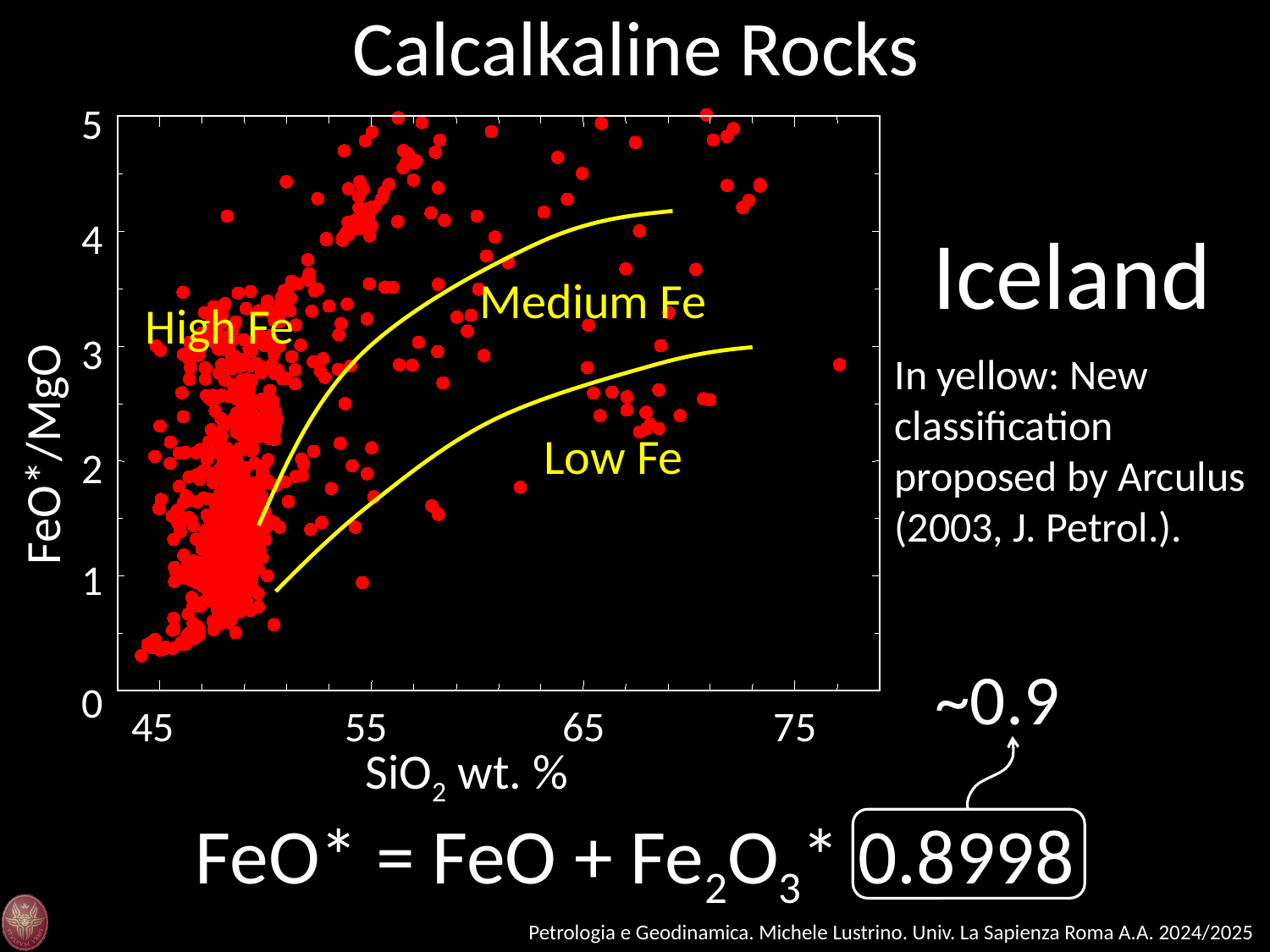
Do the FeO*/MgO values of the plotted points generally rise or fall as SiO2 wt. % increases? rise How many yellow boundary curves are drawn on the chart? 2 Is the highest value shown on the y axis of the chart greater or less than 4? greater Is the lowest SiO2 wt. % tick shown on the x axis greater or less than 50? less What is the title of the chart? Calcalkaline Rocks How many Fe classification regions are labelled on the chart? 3 What kind of chart is shown on the slide? scatter plot What quantity is plotted on the y axis of the chart? FeO*/MgO